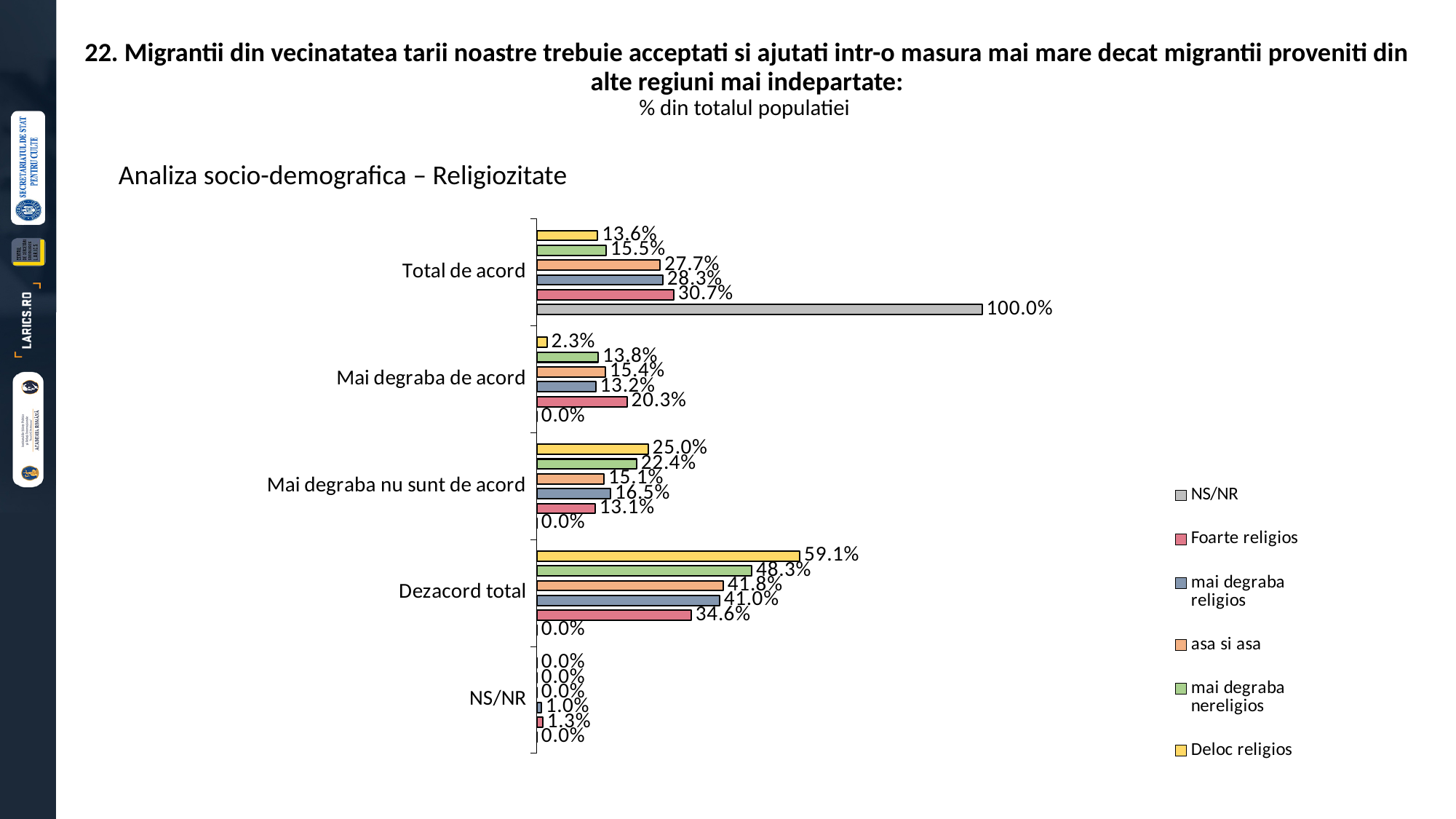
How many response categories are shown on the vertical axis? 5 In the 'Mai degraba nu sunt de acord' category, which is larger: 'Deloc religios' or 'Foarte religios'? Deloc religios Which series has the highest value in the 'Dezacord total' category? Deloc religios What is the value for 'Deloc religios' in the 'Dezacord total' category? 59.1% What kind of chart is shown on the slide? bar chart How many series does the legend list? 6 What is the difference between 'Deloc religios' and 'Foarte religios' in the 'Dezacord total' category? 24.5% What is the value for 'Foarte religios' in the 'Total de acord' category? 30.7% What is the value for 'asa si asa' in the 'Mai degraba de acord' category? 15.4% Which series is shown in grey in the legend? NS/NR What is the value for 'mai degraba religios' in the 'NS/NR' category? 1.0% Which series has the lowest value in the 'Mai degraba de acord' category, excluding the 0.0% NS/NR bar? Deloc religios